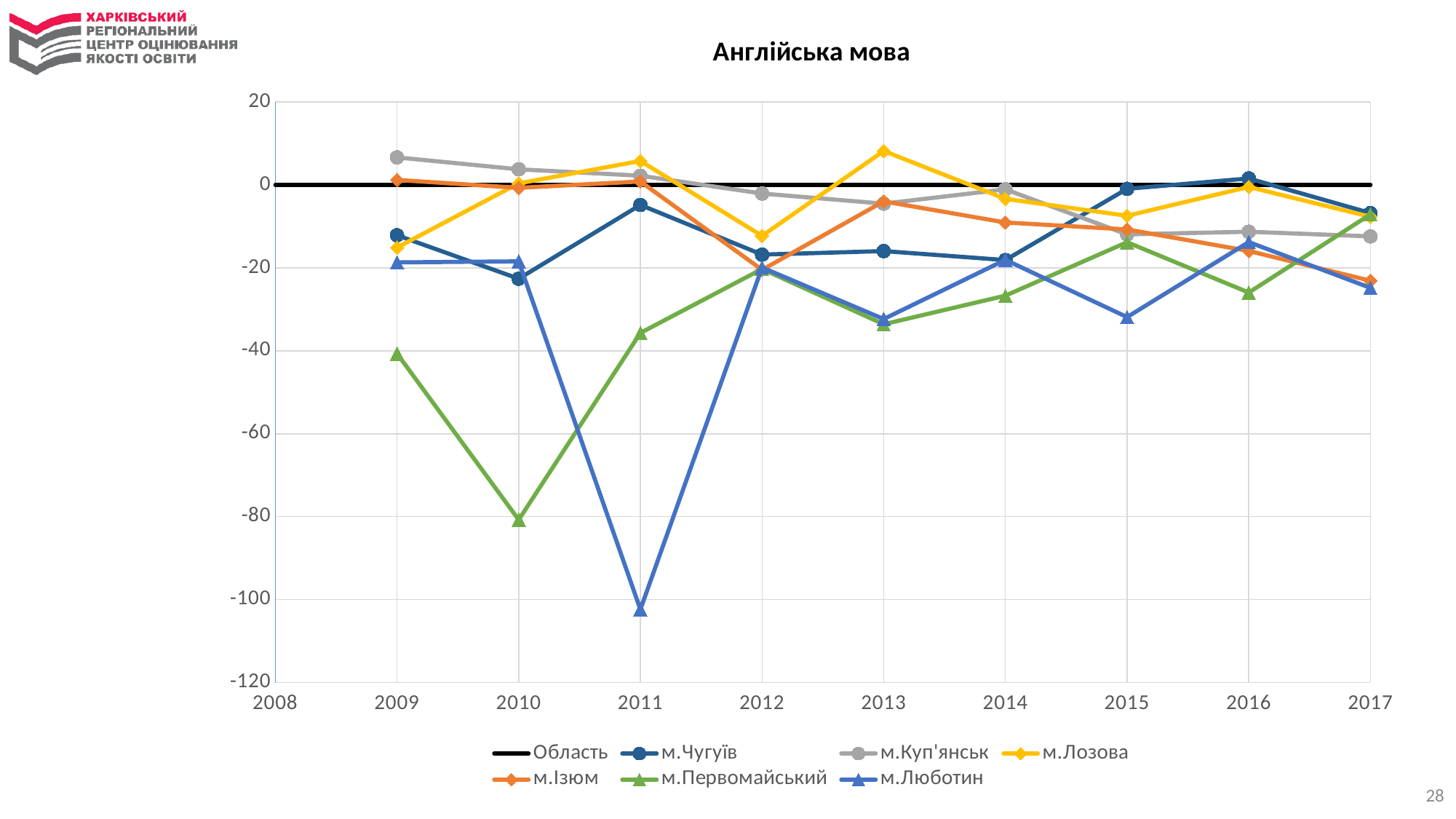
Is the value for м.Первомайський in 2010 greater or less than -60? less In which year does м.Первомайський reach its lowest value? 2010 Which series reaches the lowest value anywhere on the chart? м.Люботин What kind of chart is shown on the slide? line chart Is the value for м.Люботин in 2011 greater or less than -80? less Which is larger in 2009, the value for м.Куп'янськ or the value for м.Первомайський? м.Куп'янськ How many years have plotted data points on the chart? 10 In which year does м.Лозова reach its highest value? 2013 How many series does the legend list? 7 Is the value for м.Куп'янськ in 2009 greater or less than 0? greater What is the title of the chart? Англійська мова Does the Область line rise, fall, or stay flat across the years? stays flat